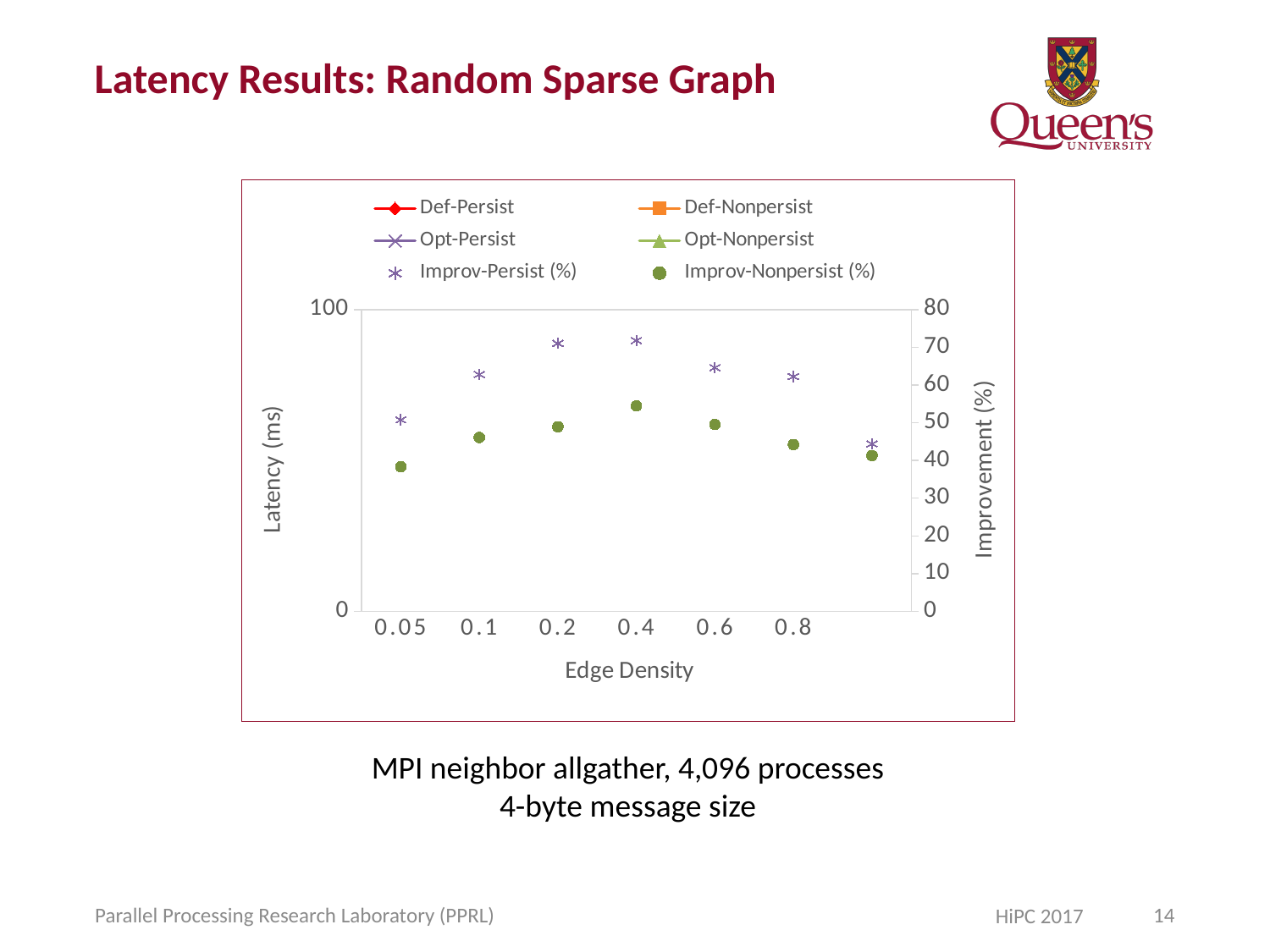
At edge density 0.4, which series has the higher improvement: Improv-Persist (%) or Improv-Nonpersist (%)? Improv-Persist (%) Is the Improv-Nonpersist (%) value at edge density 0.05 greater or less than 50? less At edge density 0.8, which series has the higher value: Improv-Persist (%) or Improv-Nonpersist (%)? Improv-Persist (%) How many edge density values are labeled on the x axis? 6 Does the Improv-Persist (%) series rise or fall from edge density 0.4 to 0.8? fall What kind of chart is shown on the slide? line chart How many series does the chart's legend list? 6 Is the Improv-Persist (%) value at edge density 0.2 greater or less than 60? greater Among the labeled edge densities, at which edge density is Improv-Nonpersist (%) highest? 0.4 Is the Improv-Persist (%) value at edge density 0.4 greater or less than 60? greater Does the Improv-Nonpersist (%) series rise or fall from edge density 0.05 to 0.4? rise What is the label of the right-hand vertical axis? Improvement (%)